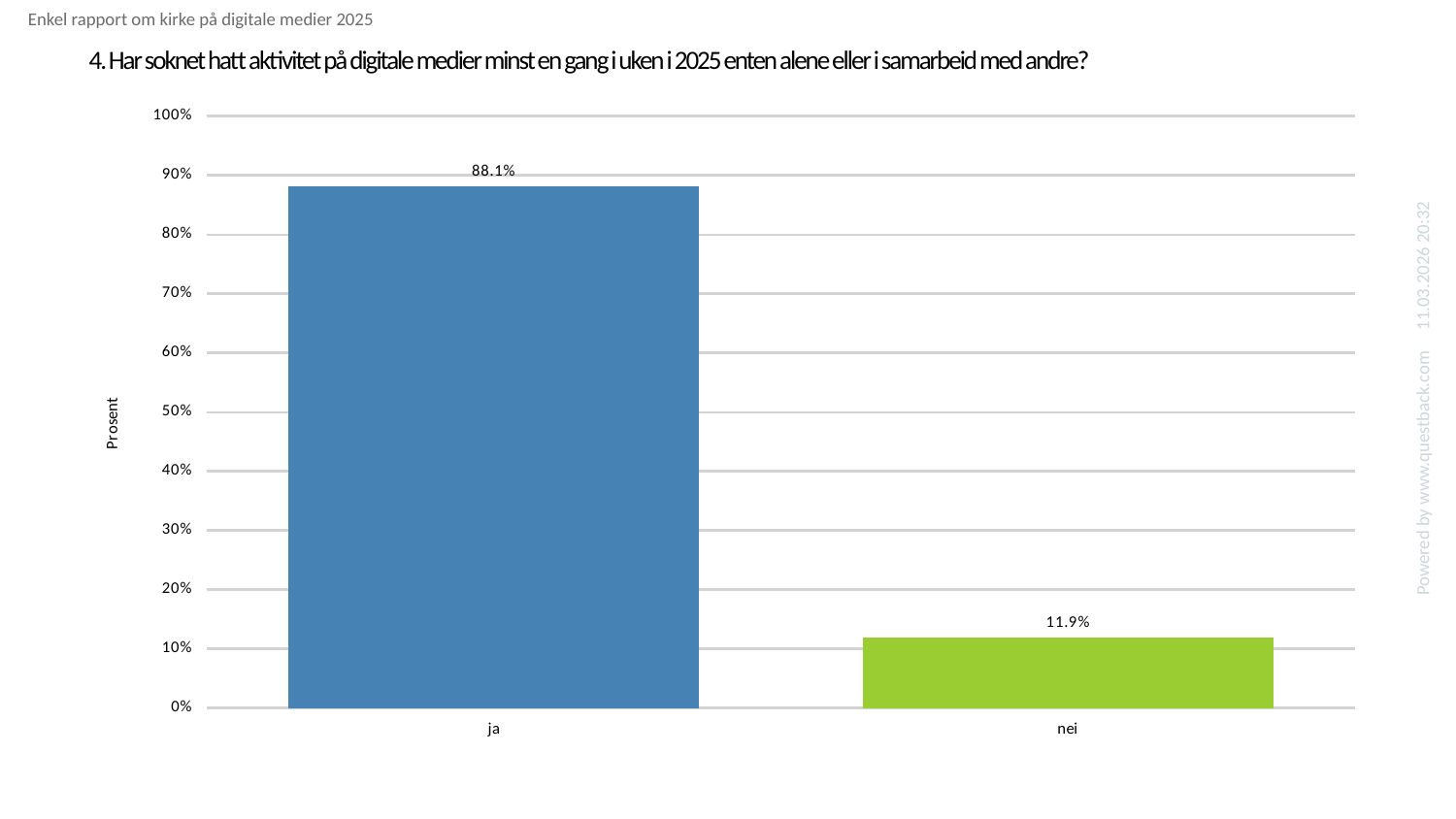
Is the value for "ja" greater or less than 80%? greater Which is larger, the value for "ja" or the value for "nei"? ja What is the difference between the values for "ja" and "nei"? 76.2% What is the value for "ja"? 88.1% How many categories are shown on the x axis? 2 What kind of chart is shown on the slide? bar chart What colour is the bar for "nei"? green Is the value for "nei" greater or less than 20%? less What is the label of the y axis? Prosent Which category has the highest value? ja Which category has the lowest value? nei What is the value for "nei"? 11.9%